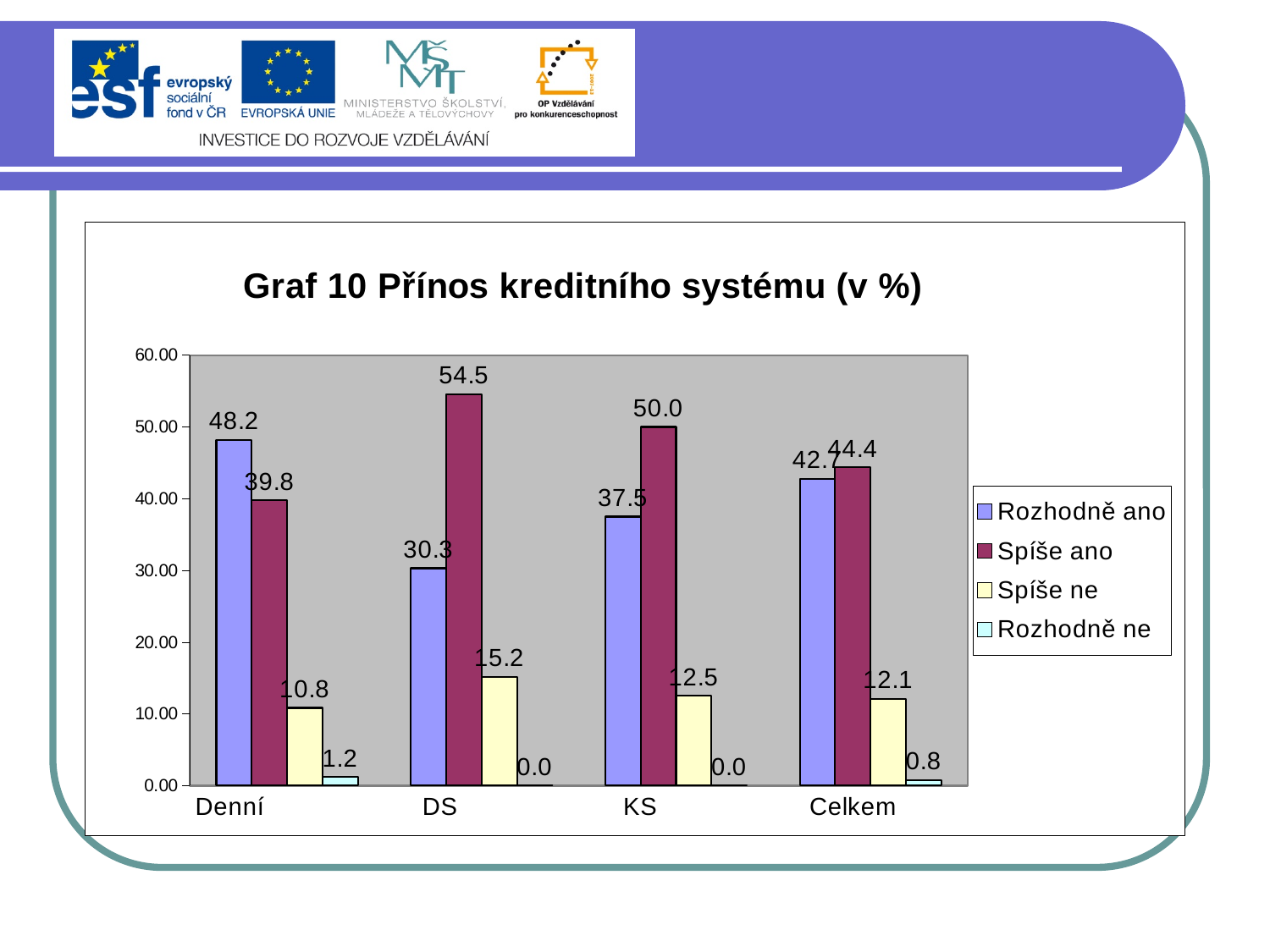
How many categories are shown on the x axis? 4 For KS, which is larger: Rozhodně ano or Spíše ano? Spíše ano What is the value of Rozhodně ne for Celkem? 0.8 What is the value of Spíše ne for KS? 12.5 What type of chart is shown on the slide? Bar chart How many series does the legend list? 4 What is the difference between Rozhodně ano and Spíše ano for Denní? 8.4 What is the value of Rozhodně ano for Denní? 48.2 Which category has the lowest value for Rozhodně ano? DS What is the value of Spíše ano for DS? 54.5 Which category has the highest value for Spíše ano? DS Is the value of Spíše ne for DS greater or less than 20.00? less